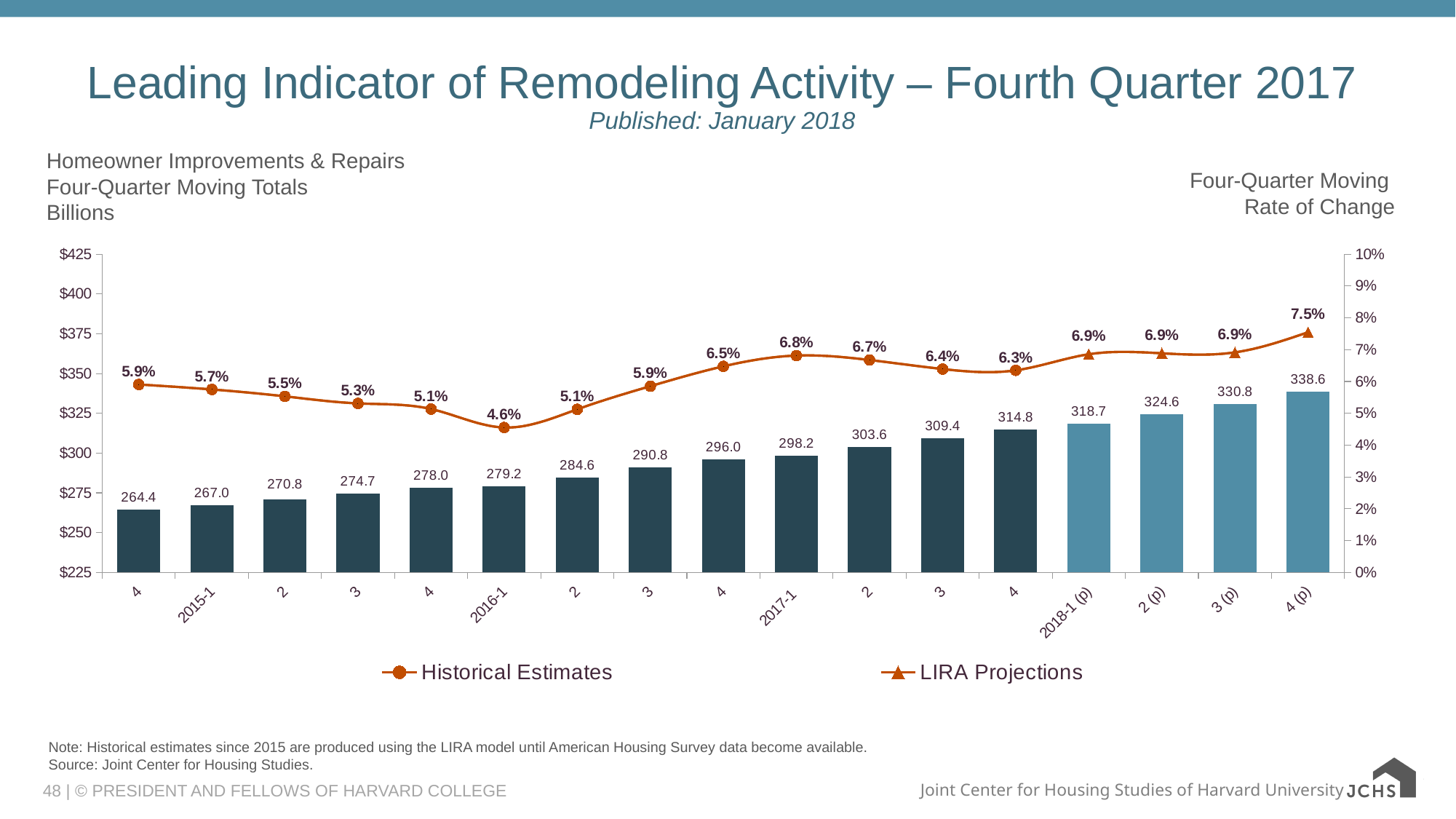
What are the two entries in the chart legend? Historical Estimates and LIRA Projections What is the four-quarter moving total for 2016-1? 279.2 Which has the higher rate of change, the second quarter of 2017 or the third quarter of 2017? Second quarter of 2017 Which quarter has the highest four-quarter moving total? 4 (p) of 2018 What is the four-quarter moving rate of change for 2017-1? 6.8% Do the four-quarter moving totals rise or fall from left to right across the chart? Rise How many series does the legend list? 2 How many bars are plotted on the chart? 17 What is the four-quarter moving total for the third quarter of 2015? 274.7 Which quarter has the lowest four-quarter moving rate of change? 2016-1 What is the difference between the four-quarter moving totals for 2018-1 (p) and the fourth quarter of 2017? 3.9 What kind of chart is shown? Combination bar and line chart